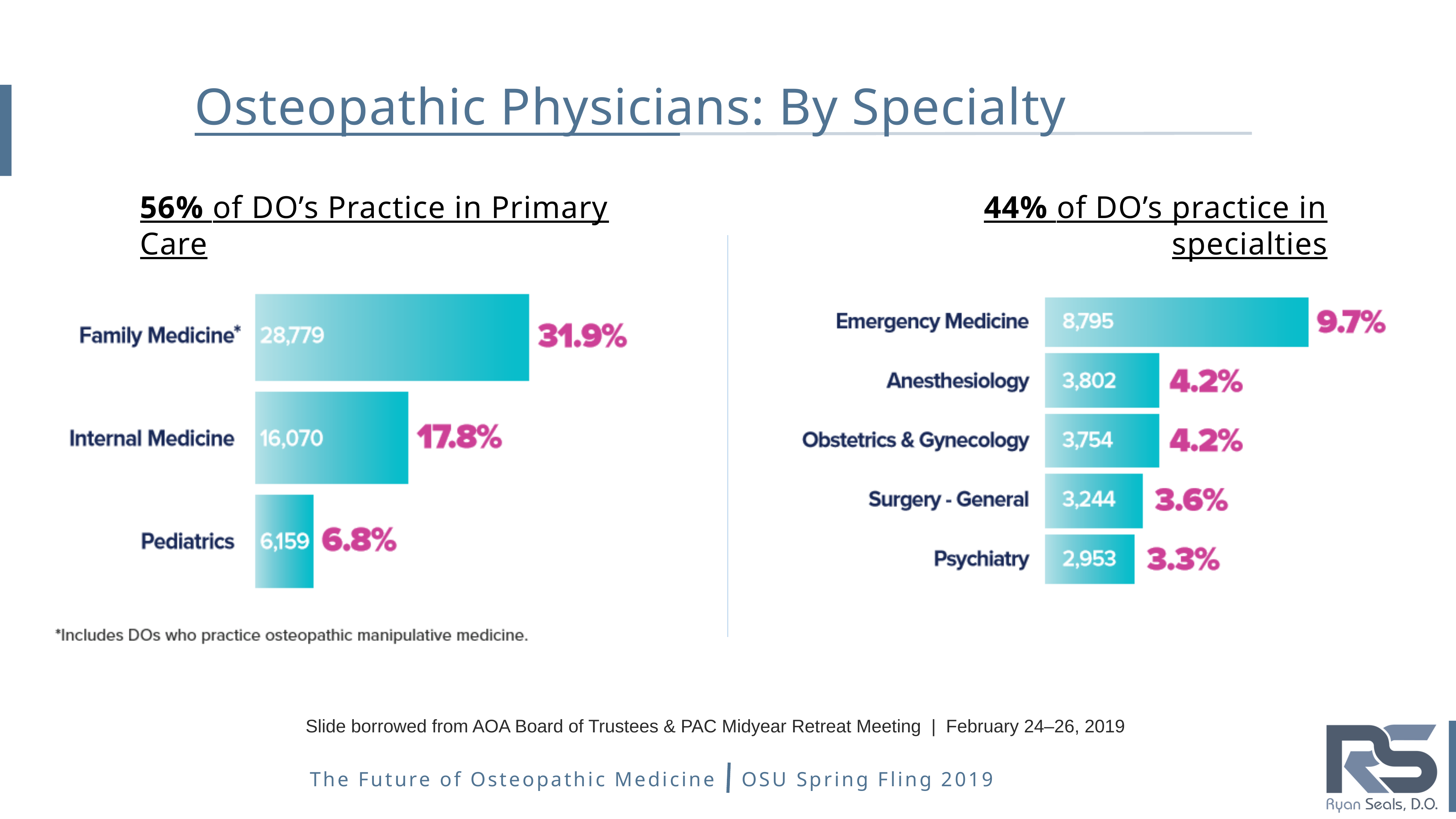
In the left chart (Primary Care), how many specialties are shown? 3 In the left chart (Primary Care), how many DOs practice Family Medicine? 28,779 In the right chart (specialties), how many specialties are listed? 5 In the left chart (Primary Care), which specialty has the lowest count? Pediatrics In the right chart (specialties), what is the difference in count between Anesthesiology and Obstetrics & Gynecology? 48 In the right chart (specialties), which has a larger count, Anesthesiology or Surgery - General? Anesthesiology What type of chart is used on the left side of the slide? Bar chart In the right chart (specialties), which specialty has the highest count? Emergency Medicine In the right chart (specialties), what percentage is shown for Psychiatry? 3.3% In the left chart (Primary Care), what is the difference in count between Family Medicine and Internal Medicine? 12,709 In the left chart (Primary Care), what percentage is shown for Internal Medicine? 17.8% In the right chart (specialties), how many DOs practice Emergency Medicine? 8,795